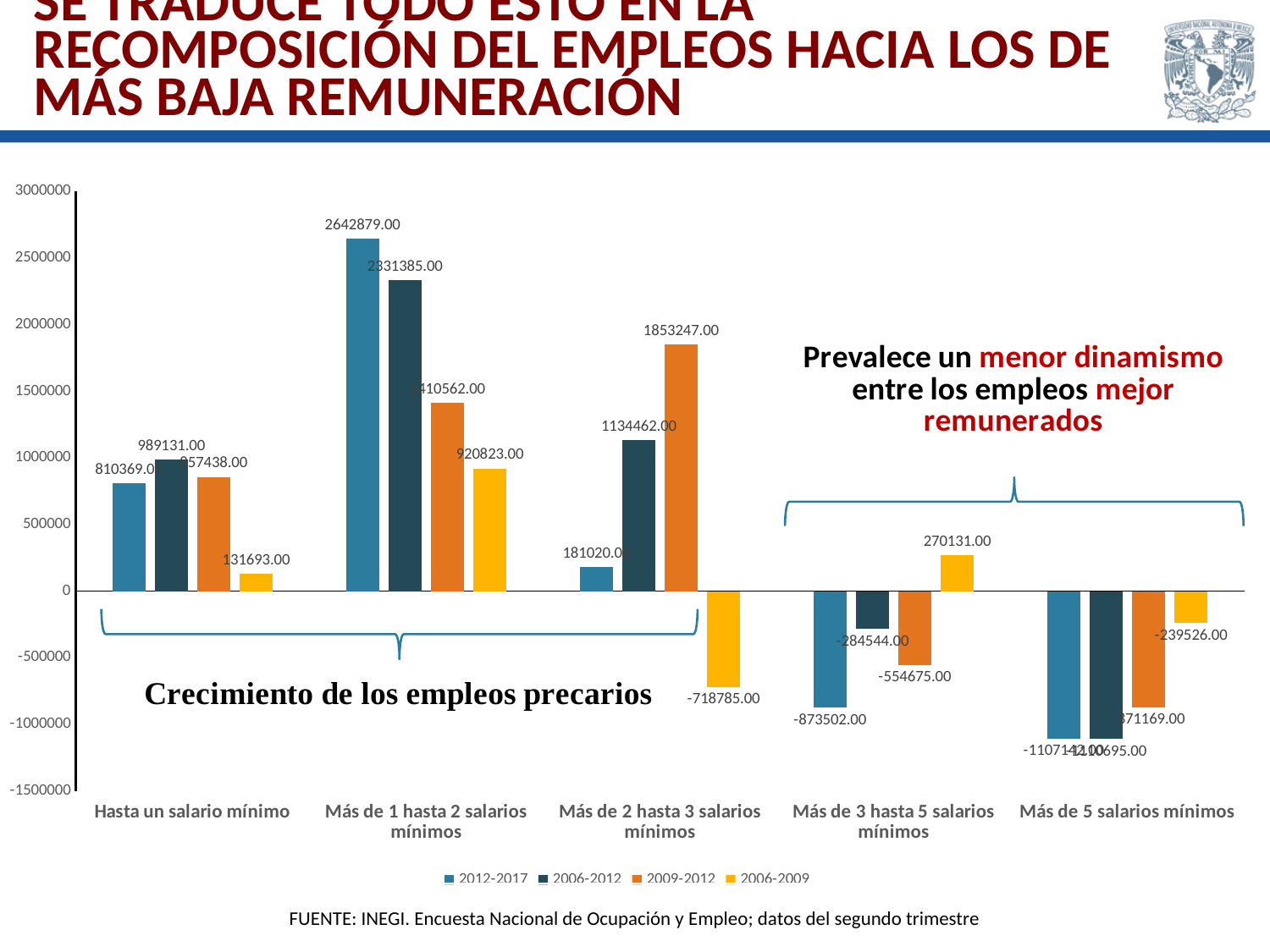
What is the value for 2006-2012 in the 'Hasta un salario mínimo' category? 989131.00 What is the value for 2009-2012 in the 'Más de 2 hasta 3 salarios mínimos' category? 1853247.00 How many series does the legend list? 4 What is the value for 2006-2009 in the 'Más de 5 salarios mínimos' category? -239526.00 What kind of chart is shown on the slide? bar chart Which category has the highest value for the 2012-2017 series? Más de 1 hasta 2 salarios mínimos How many salary categories are shown on the x axis? 5 Is the 2012-2017 value for 'Más de 3 hasta 5 salarios mínimos' greater or less than -500000? less In the 'Más de 2 hasta 3 salarios mínimos' category, which is larger: the 2009-2012 value or the 2006-2012 value? 2009-2012 What is the value for 2006-2009 in the 'Más de 3 hasta 5 salarios mínimos' category? 270131.00 What is the value for 2006-2009 in the 'Más de 1 hasta 2 salarios mínimos' category? 920823.00 What is the difference between the 2012-2017 and 2006-2012 values in the 'Más de 1 hasta 2 salarios mínimos' category? 311494.00